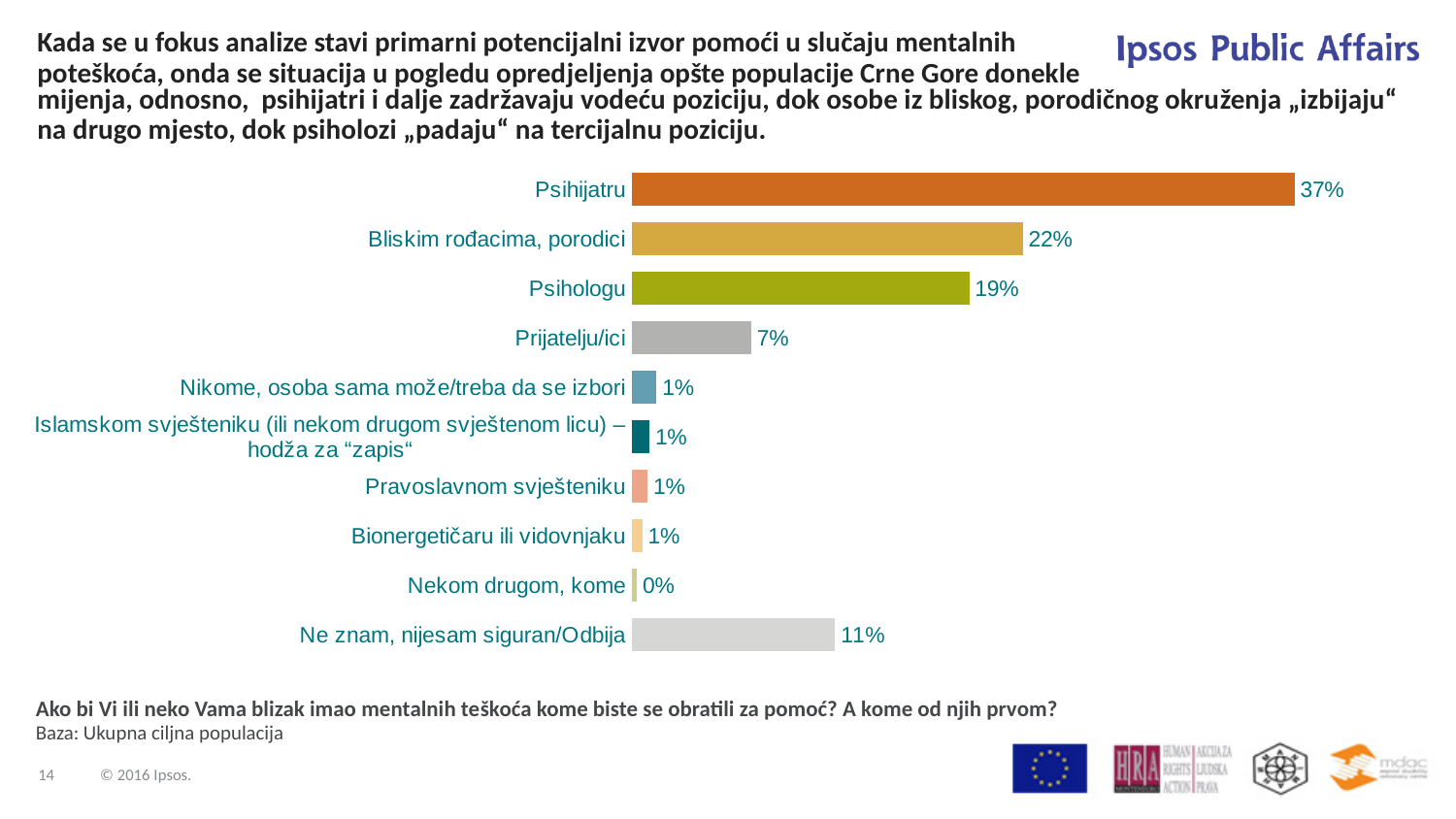
How many categories are shown in the chart? 10 What is the value for Psihologu? 19% What is the difference between the values for Psihijatru and Bliskim rođacima, porodici? 15% What is the difference between the values for Psihologu and Prijatelju/ici? 12% What kind of chart is shown on the slide? Bar chart What is the value for Prijatelju/ici? 7% Which category has the lowest value? Nekom drugom, kome What is the value for Psihijatru? 37% Which is larger, the value for Psihologu or the value for Ne znam, nijesam siguran/Odbija? Psihologu What is the value for Bliskim rođacima, porodici? 22% Which category has the highest value? Psihijatru What is the value for Ne znam, nijesam siguran/Odbija? 11%